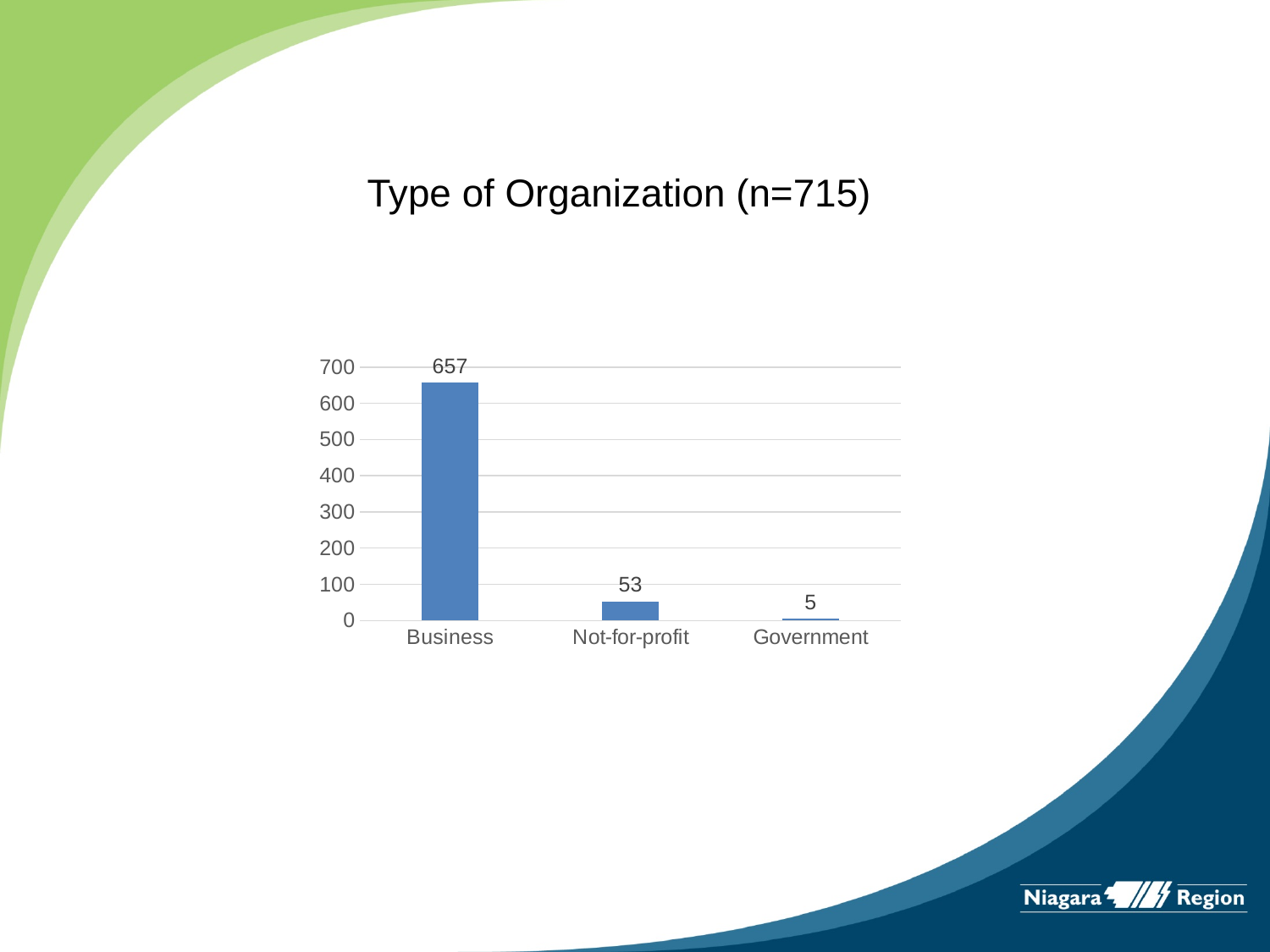
What is the value for Not-for-profit? 53 What is the value for Business? 657 Which is larger, the value for Not-for-profit or the value for Government? Not-for-profit What is the title of the chart? Type of Organization (n=715) What is the difference between the values for Business and Not-for-profit? 604 Which category has the highest value? Business What is the difference between the values for Not-for-profit and Government? 48 Which category has the lowest value? Government What kind of chart is shown on the slide? bar chart How many categories are shown on the x axis? 3 Is the value for Business greater or less than 600? greater What is the value for Government? 5